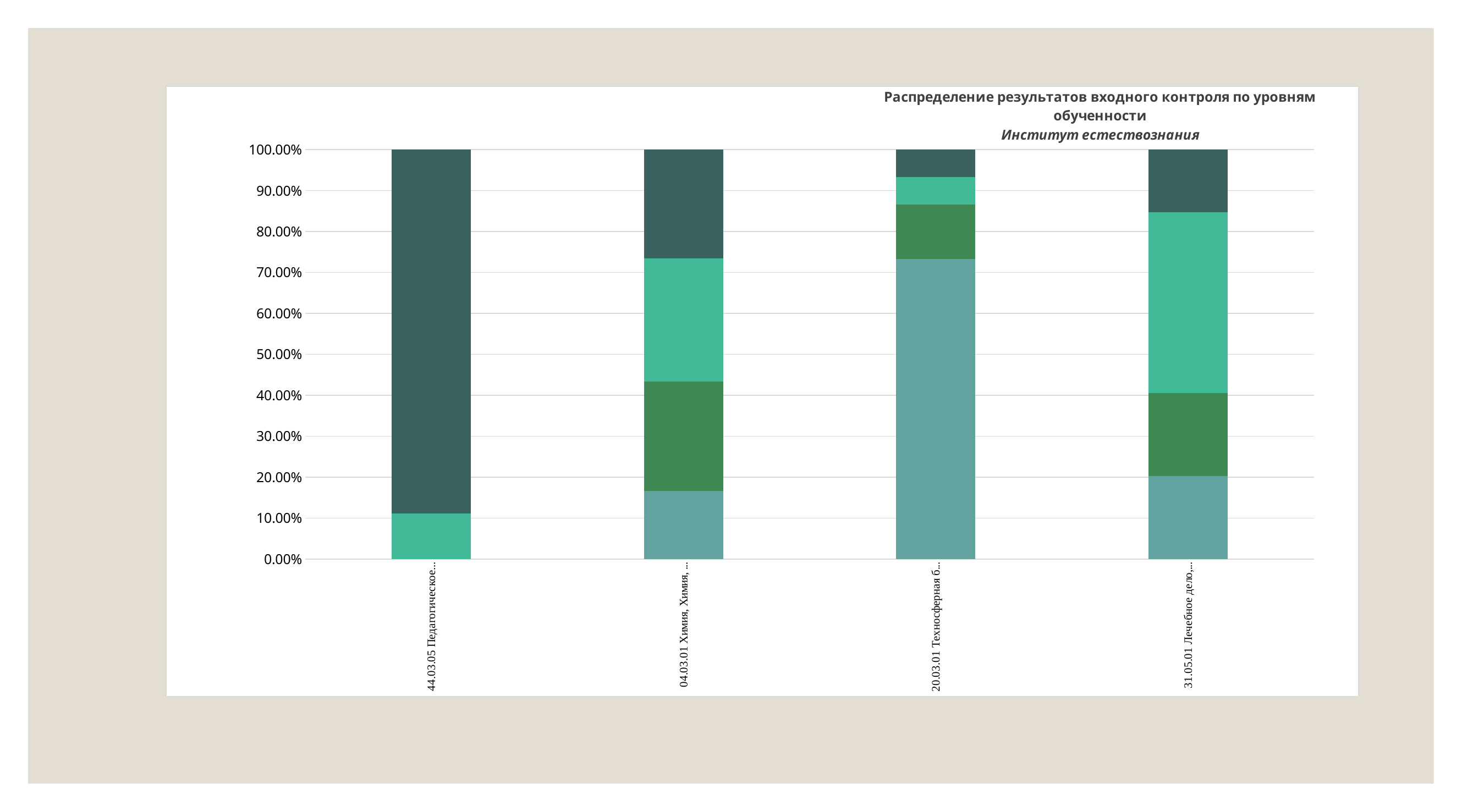
How many categories (bars) are plotted on the chart? 4 Does the bottom edge of the top (darkest) segment of the bar for 20.03.01 Техносферная б... sit above or below 90%? above What is the total height of each stacked bar on the chart? 100.00% Is the top of the bottom segment of the bar for 44.03.05 Педагогическое... greater or less than 20%? less Which institute is named in the italic subtitle of the chart? Институт естествознания Is the top of the bottom (lightest) segment of the bar for 20.03.01 Техносферная б... greater or less than 70%? greater What is the title of the chart? Распределение результатов входного контроля по уровням обученности Which bar has the larger bottom (lightest) segment: 20.03.01 Техносферная б... or 04.03.01 Химия, Химия, ...? 20.03.01 Техносферная б... What kind of chart is shown on the slide? stacked bar chart